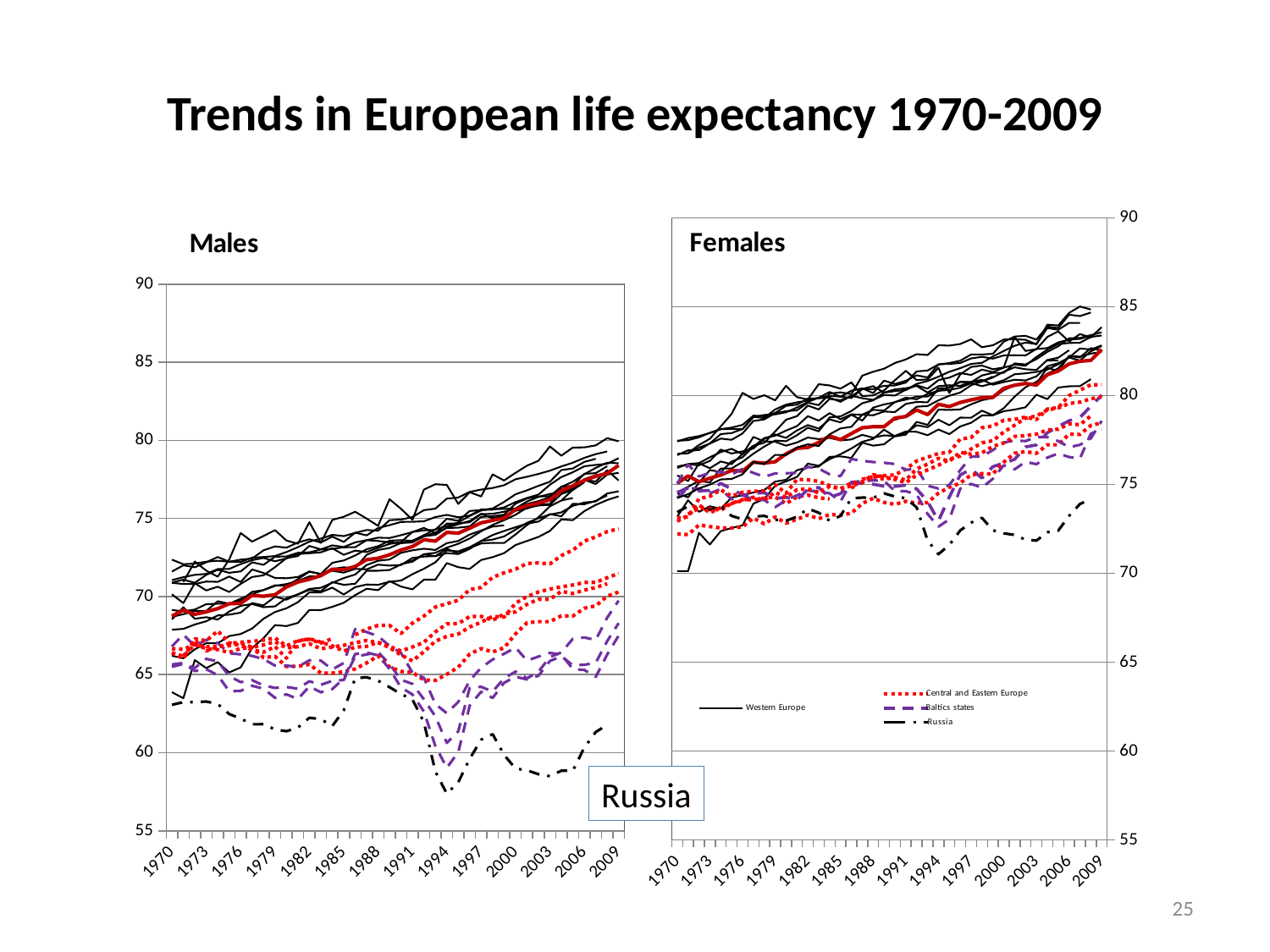
How many series does the legend on the Females chart list? 4 What kind of chart is the Males chart? line chart On the Females chart, is the value for Russia in 1994 greater or less than 75? less In the legend, which series is drawn as a dash-dot black line? Russia What is the title of the slide's chart? Trends in European life expectancy 1970-2009 On the Males chart, which group has the lowest life expectancy in 2009? Russia On the Females chart, which group has the lowest life expectancy in 2009? Russia On the Females chart, which is higher in 2009: Russia or the Western Europe lines? Western Europe On the Males chart, do the Western Europe lines rise or fall from 1970 to 2009? rise On the Males chart, is the value for Russia in 1994 greater or less than 60? less